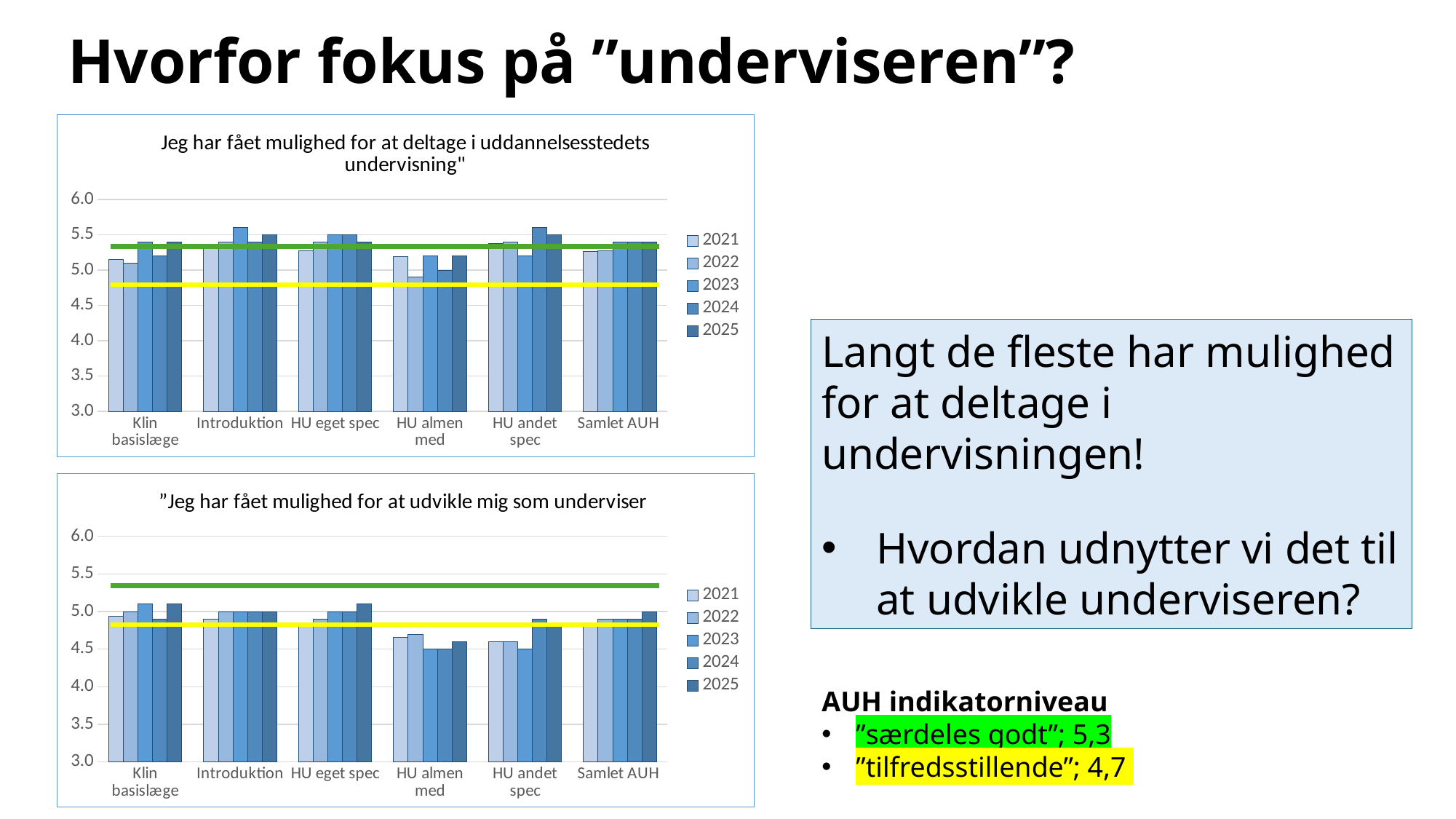
In the bottom chart ("Jeg har fået mulighed for at udvikle mig som underviser"), how many categories are shown on the x axis? 6 In the bottom chart ("Jeg har fået mulighed for at udvikle mig som underviser"), which years are listed in the legend? 2021, 2022, 2023, 2024, 2025 In the top chart ("Jeg har fået mulighed for at deltage i uddannelsesstedets undervisning"), is the 2021 value for Klin basislæge greater or less than 5.5? less In the top chart ("Jeg har fået mulighed for at deltage i uddannelsesstedets undervisning"), how many series does the legend list? 5 In the bottom chart ("Jeg har fået mulighed for at udvikle mig som underviser"), is the 2021 value for HU andet spec greater or less than 5.0? less In the top chart ("Jeg har fået mulighed for at deltage i uddannelsesstedets undervisning"), which is larger: the 2021 value for Klin basislæge or the 2023 value for Introduktion? 2023 value for Introduktion In the bottom chart ("Jeg har fået mulighed for at udvikle mig som underviser"), is the 2024 value for HU almen med greater or less than 5.0? less In the bottom chart ("Jeg har fået mulighed for at udvikle mig som underviser"), which is larger: the 2023 value for Klin basislæge or the 2023 value for HU almen med? 2023 value for Klin basislæge In the top chart ("Jeg har fået mulighed for at deltage i uddannelsesstedets undervisning"), which category has the lowest 2022 value? HU almen med What kind of chart is the bottom chart titled "Jeg har fået mulighed for at udvikle mig som underviser"? bar chart In the top chart ("Jeg har fået mulighed for at deltage i uddannelsesstedets undervisning"), how many categories are shown on the x axis? 6 What kind of chart is the top chart titled "Jeg har fået mulighed for at deltage i uddannelsesstedets undervisning"? bar chart